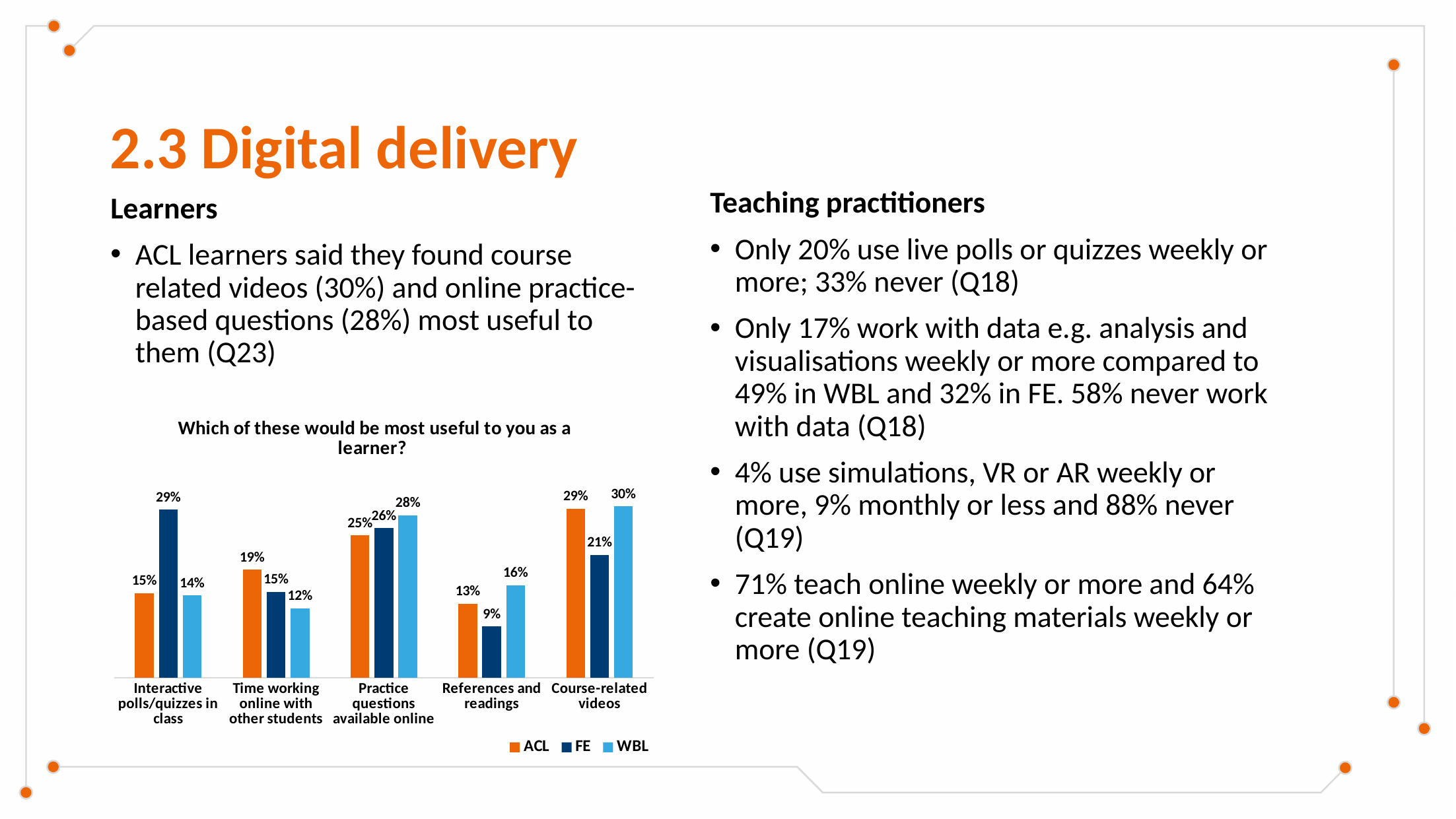
How many series does the chart legend list? 3 Which category has the highest ACL value? Course-related videos What is the ACL value for Time working online with other students? 19% What type of chart is shown on the slide? Bar chart How many categories are shown on the x axis of the chart? 5 What is the FE value for Interactive polls/quizzes in class? 29% What is the FE value for References and readings? 9% What is the difference between the FE and ACL values for Interactive polls/quizzes in class? 14% For Practice questions available online, which is larger: the ACL value or the WBL value? WBL Which category has the lowest WBL value? Time working online with other students What is the difference between the WBL and FE values for Course-related videos? 9% What is the WBL value for Course-related videos? 30%